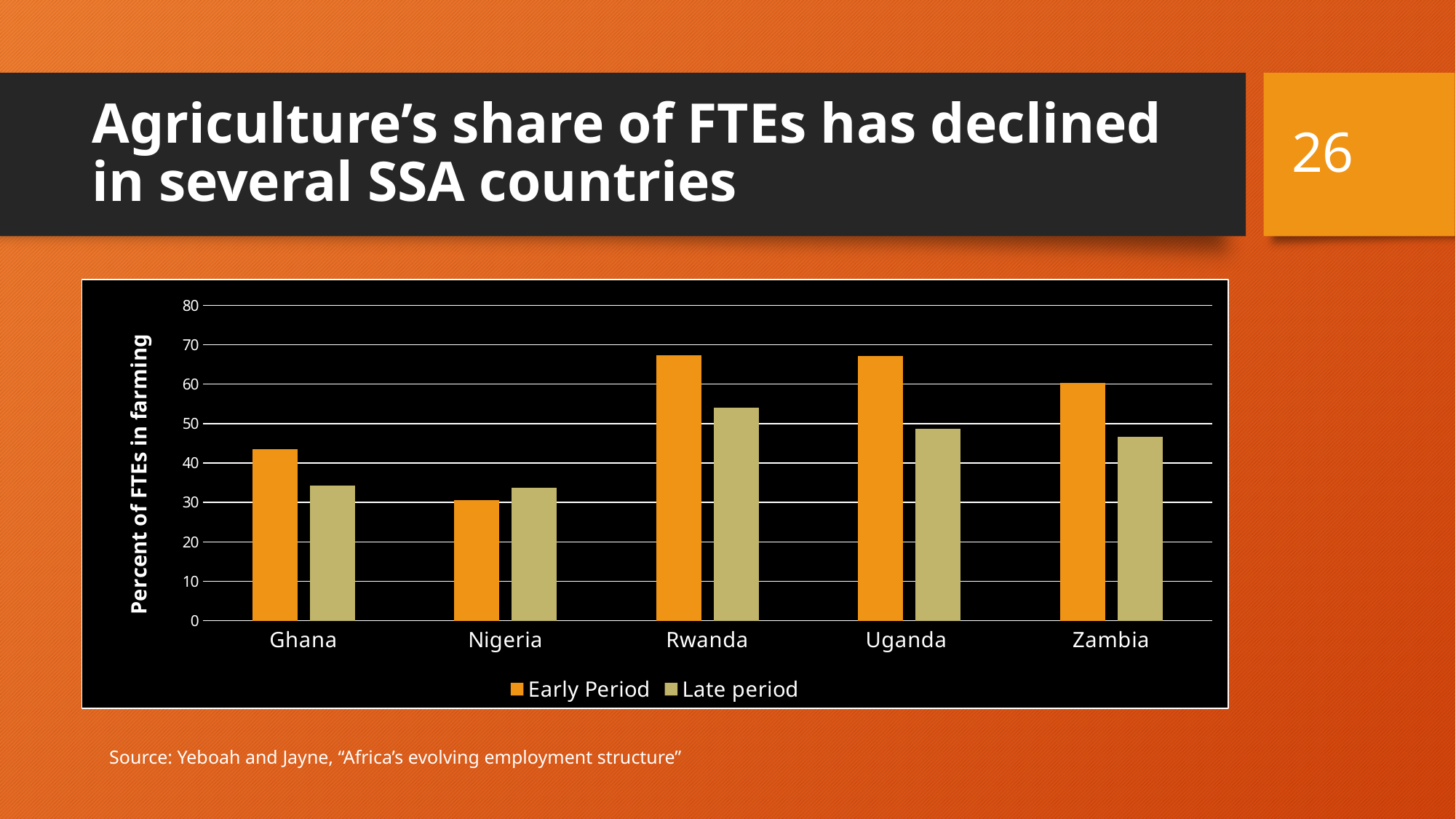
Is the Early Period value for Ghana greater or less than 40? greater Is the Late period value for Zambia greater or less than 50? less Is the Early Period value for Uganda greater or less than 60? greater For Ghana, which is larger: the Early Period value or the Late period value? Early Period How many series does the chart's legend list? 2 Which country has the highest Late period value? Rwanda How many countries are shown on the x axis of the chart? 5 What is the label on the vertical axis of the chart? Percent of FTEs in farming What kind of chart is shown on the slide? bar chart Which country has the lowest Early Period value? Nigeria For Nigeria, which is larger: the Early Period value or the Late period value? Late period